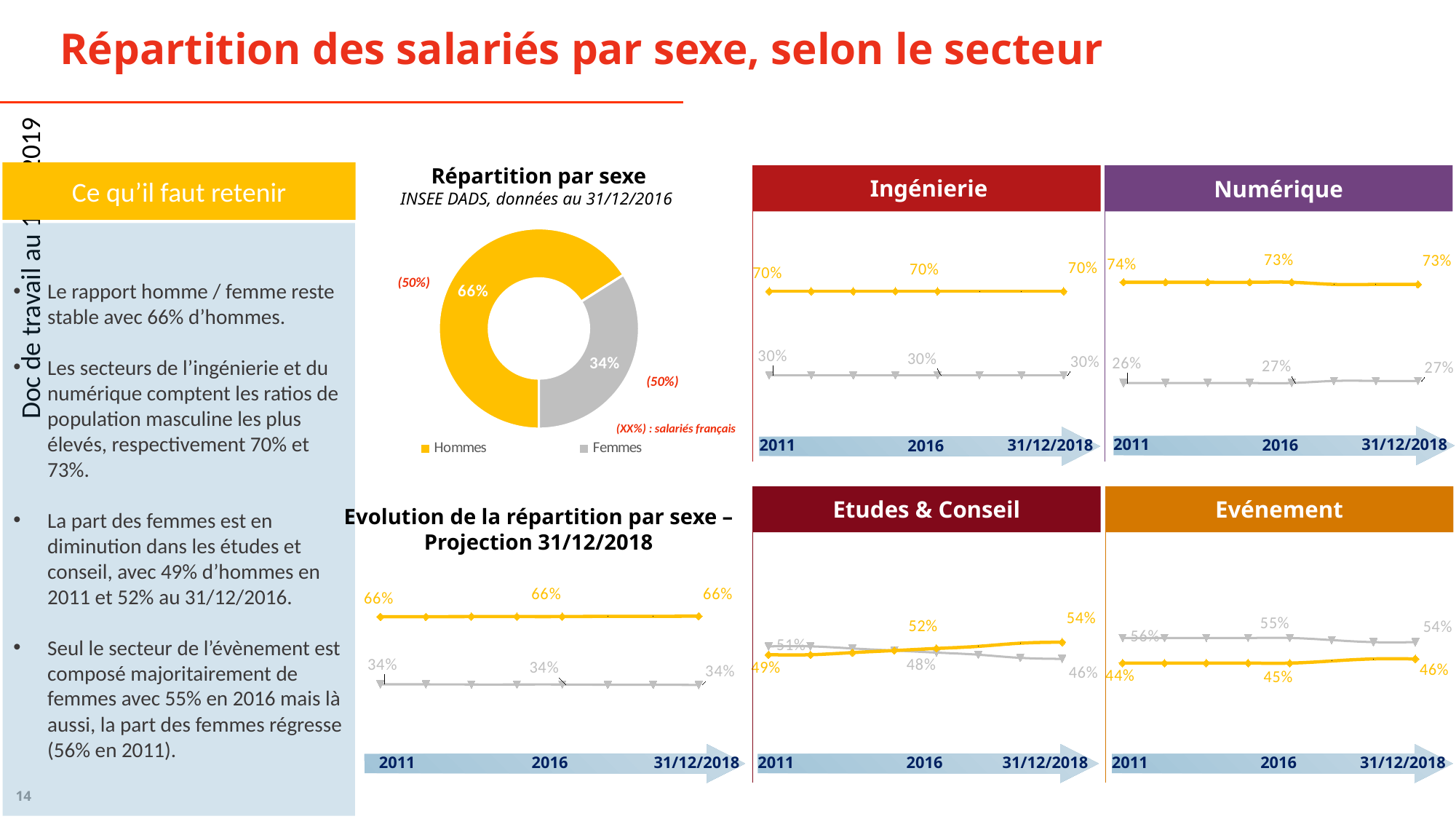
In the 'Numérique' chart, what is the value of the yellow (Hommes) line in 2011? 74% In the 'Répartition par sexe' chart, what share of the donut is Hommes? 66% How many series does the legend of the 'Répartition par sexe' chart list? 2 In the 'Etudes & Conseil' chart, what is the grey (Femmes) value in 2016? 48% In the 'Ingénierie' chart, what is the value of the yellow (Hommes) line in 2016? 70% How many time points are shown on the x axis of the 'Evolution de la répartition par sexe – Projection 31/12/2018' chart? 3 What kind of chart is 'Répartition par sexe'? Donut (pie) chart In the 'Evénement' chart, what is the grey (Femmes) value at 31/12/2018? 54% In the 'Etudes & Conseil' chart, does the yellow (Hommes) line rise or fall from 2011 to 31/12/2018? Rise In the 'Evénement' chart, which is larger in 2011: the Hommes value or the Femmes value? Femmes In the 'Numérique' chart, what is the difference between the Hommes and Femmes values at 31/12/2018? 46 percentage points In the 'Répartition par sexe' chart, what share of the donut is Femmes? 34%